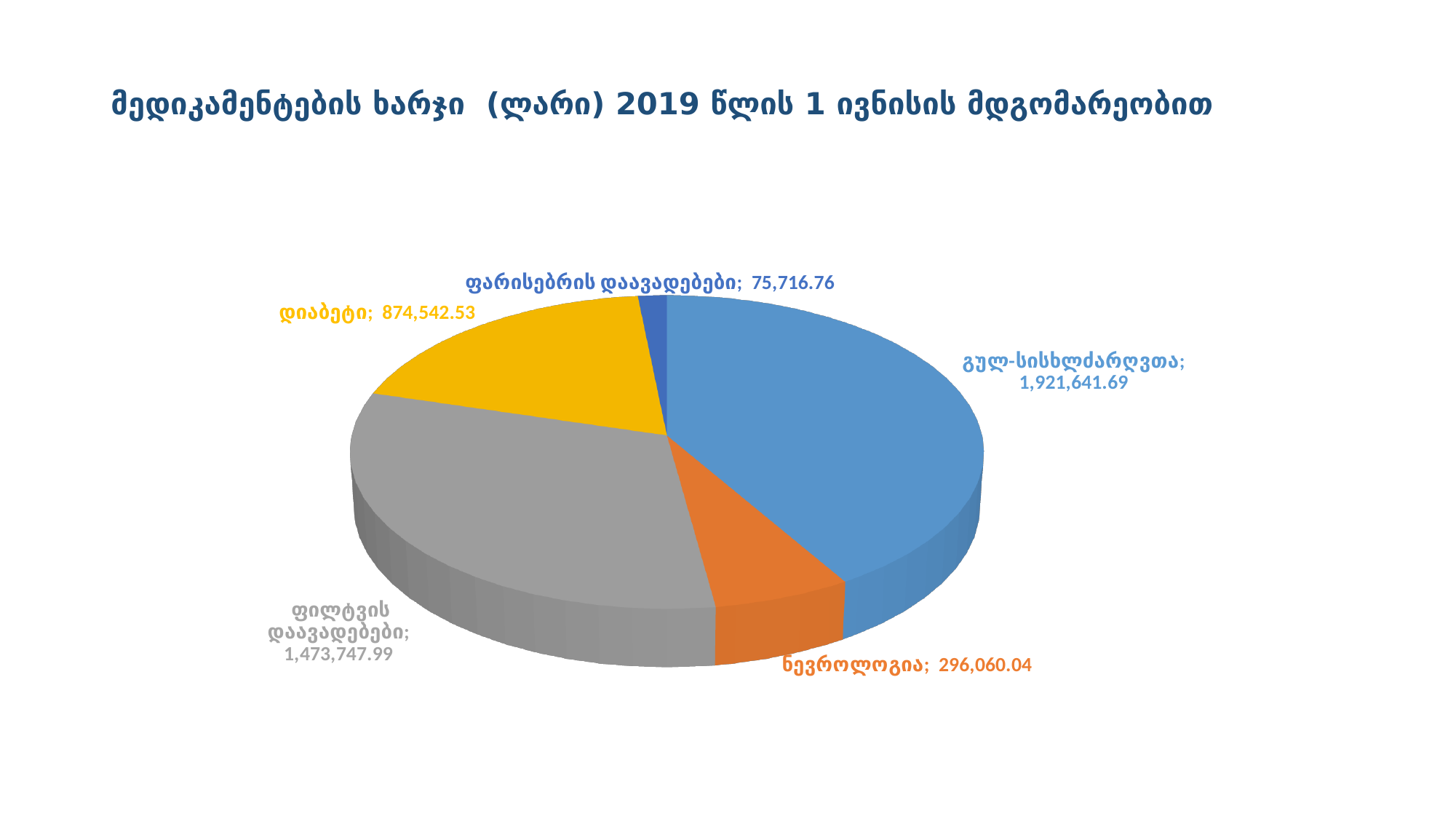
What is the value for ფარისებრის დაავადებები? 75,716.76 Which is larger, the value for დიაბეტი or the value for ნევროლოგია? დიაბეტი How many categories are shown in the pie chart? 5 What is the value for გულ-სისხლძარღვთა? 1,921,641.69 What is the difference between the values for გულ-სისხლძარღვთა and ფილტვის დაავადებები? 447,893.70 What is the value for დიაბეტი? 874,542.53 What type of chart is shown on the slide? Pie chart Which category has the smallest slice of the pie? ფარისებრის დაავადებები What is the difference between the values for დიაბეტი and ნევროლოგია? 578,482.49 Which category has the largest slice of the pie? გულ-სისხლძარღვთა What is the value for ნევროლოგია? 296,060.04 What is the value for ფილტვის დაავადებები? 1,473,747.99